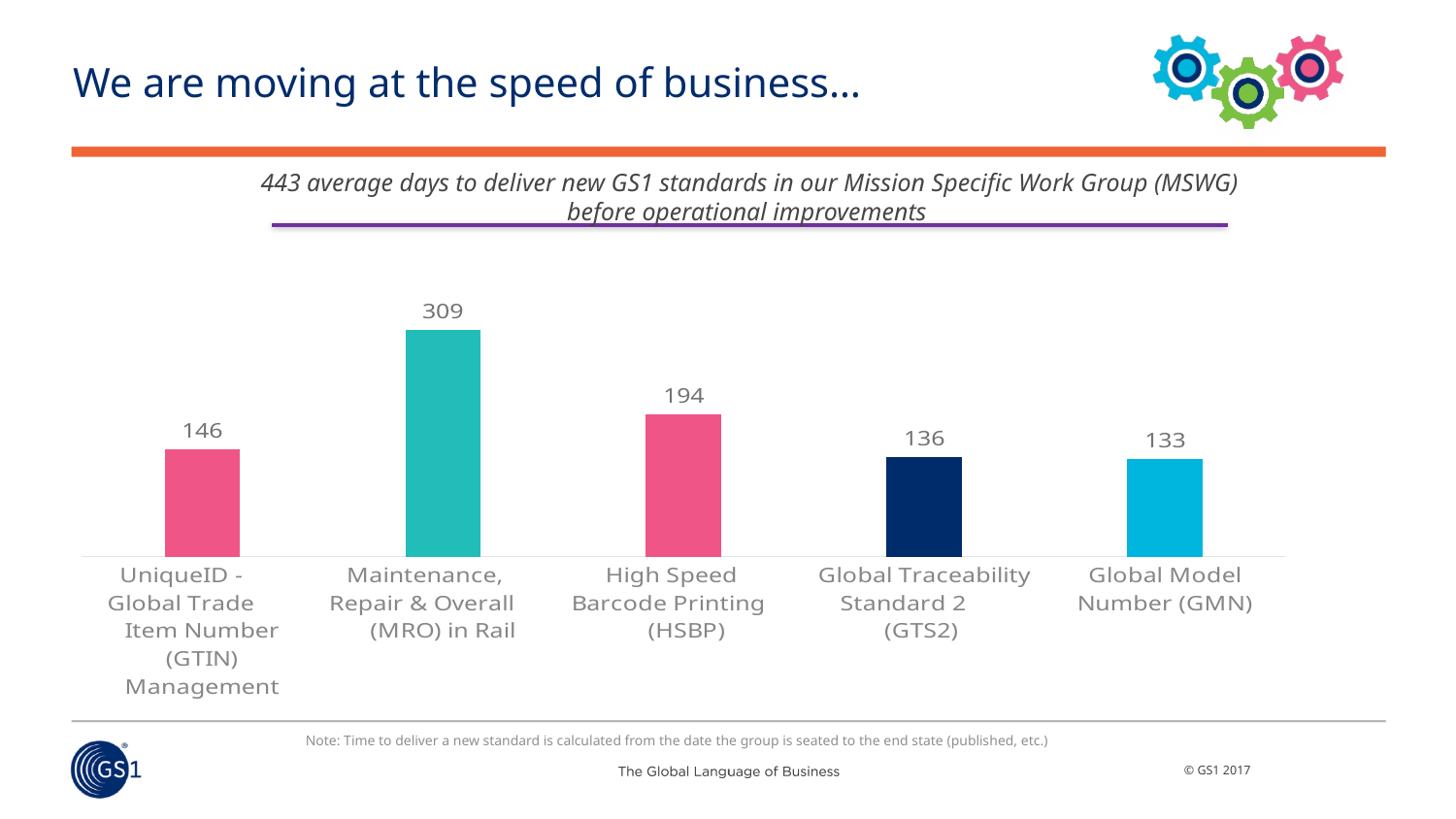
According to the text above the chart, what was the average number of days to deliver new GS1 standards in the MSWG before operational improvements? 443 What is the value for High Speed Barcode Printing (HSBP)? 194 Which is larger, the value for UniqueID - Global Trade Item Number (GTIN) Management or the value for High Speed Barcode Printing (HSBP)? High Speed Barcode Printing (HSBP) What is the difference between the values for UniqueID - Global Trade Item Number (GTIN) Management and Global Traceability Standard 2 (GTS2)? 10 What is the value for Global Traceability Standard 2 (GTS2)? 136 How many categories are shown in the chart? 5 What is the value for Maintenance, Repair & Overall (MRO) in Rail? 309 What is the value for Global Model Number (GMN)? 133 Which category has the highest value? Maintenance, Repair & Overall (MRO) in Rail What is the difference between the values for Maintenance, Repair & Overall (MRO) in Rail and High Speed Barcode Printing (HSBP)? 115 What kind of chart is shown on the slide? Bar chart Which category has the lowest value? Global Model Number (GMN)